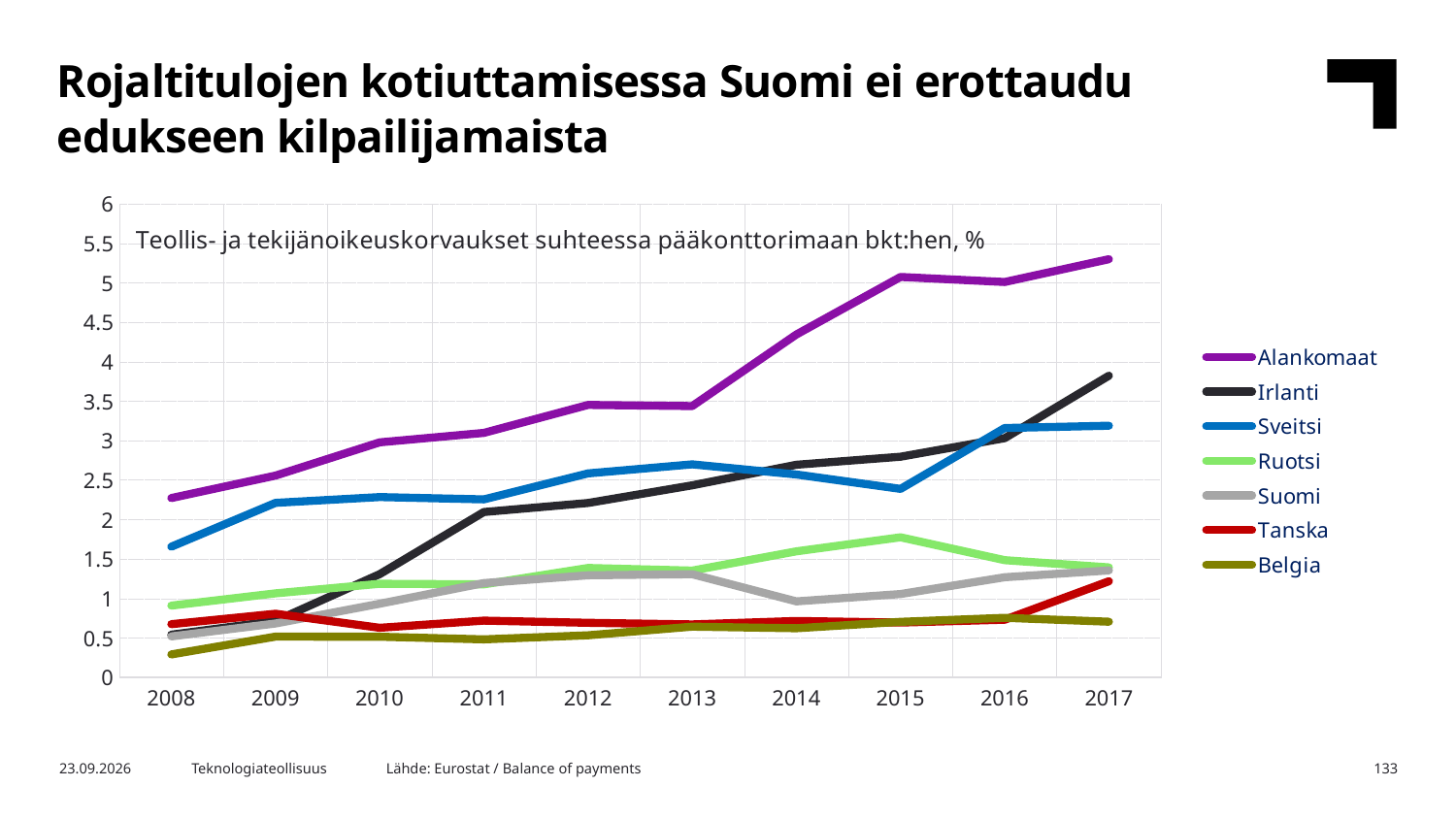
Which country has the highest value in 2017? Alankomaat How many years are shown on the x axis? 10 What is the title text shown inside the chart area? Teollis- ja tekijänoikeuskorvaukset suhteessa pääkonttorimaan bkt:hen, % What kind of chart is shown on the slide? line chart Is the value for Irlanti in 2017 greater or less than 3.5? greater Is the value for Belgia in 2008 greater or less than 0.5? less In 2015, which is higher: Irlanti or Sveitsi? Irlanti How many series does the legend list? 7 Does the Alankomaat line rise or fall from 2008 to 2017? rise Is the value for Suomi in 2014 greater or less than 1.5? less Which country has the lowest value in 2008? Belgia